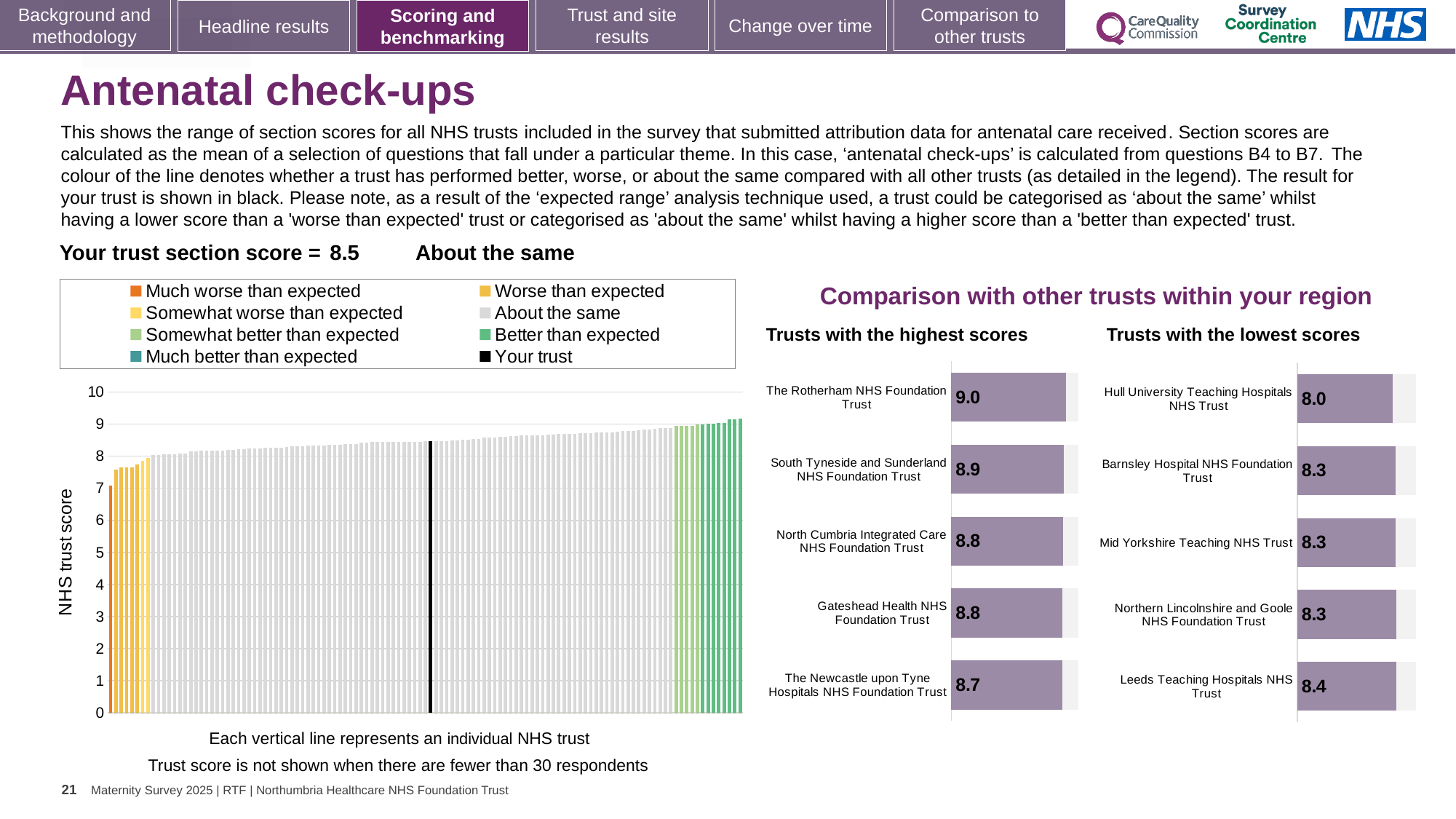
In the 'Trusts with the highest scores' chart, what is the score for The Rotherham NHS Foundation Trust? 9.0 What kind of chart is the main 'NHS trust score' chart on the left of the slide? Bar chart In the 'Trusts with the highest scores' chart, which trust has the highest score? The Rotherham NHS Foundation Trust In the 'Trusts with the lowest scores' chart, which trust has the lowest score? Hull University Teaching Hospitals NHS Trust In the 'Trusts with the lowest scores' chart, what is the score for Hull University Teaching Hospitals NHS Trust? 8.0 How many entries does the legend of the main 'NHS trust score' chart on the left list? 8 In the 'Trusts with the highest scores' chart, what is the difference between the scores of The Rotherham NHS Foundation Trust and The Newcastle upon Tyne Hospitals NHS Foundation Trust? 0.3 In the 'Trusts with the lowest scores' chart, what is the difference between the scores of Leeds Teaching Hospitals NHS Trust and Hull University Teaching Hospitals NHS Trust? 0.4 In the main 'NHS trust score' chart on the left, do the trust scores rise or fall from left to right? Rise How many trusts are shown in the 'Trusts with the highest scores' chart? 5 In the 'Trusts with the highest scores' chart, which has the higher score: South Tyneside and Sunderland NHS Foundation Trust or Gateshead Health NHS Foundation Trust? South Tyneside and Sunderland NHS Foundation Trust In the 'Trusts with the lowest scores' chart, what is the score for Leeds Teaching Hospitals NHS Trust? 8.4